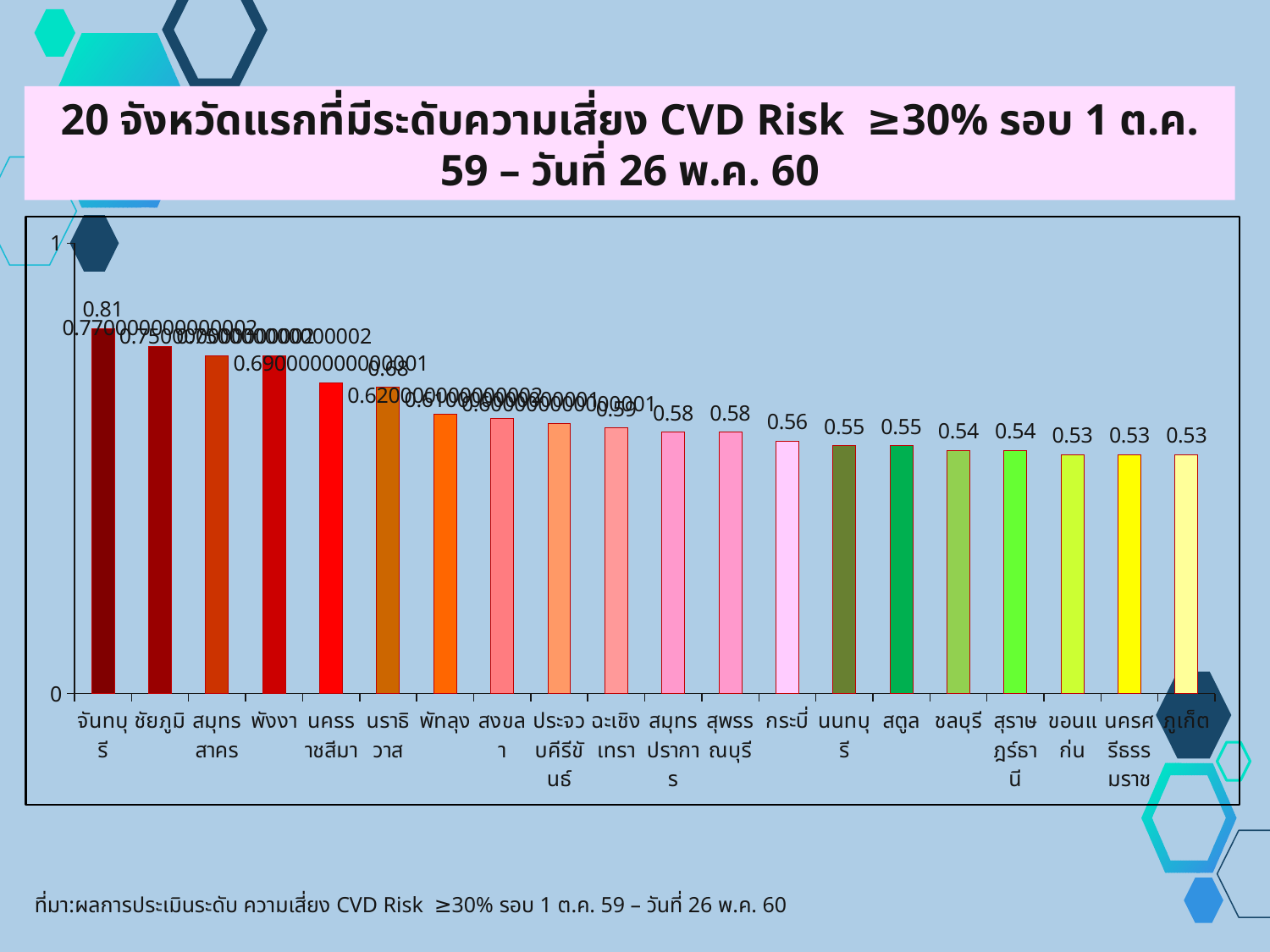
What is the value shown for ชลบุรี? 0.54 Do the values rise or fall moving from left to right along the x axis? fall What is the value shown for ภูเก็ต? 0.53 What is the title of the chart on the slide? 20 จังหวัดแรกที่มีระดับความเสี่ยง CVD Risk ≥30% รอบ 1 ต.ค. 59 – วันที่ 26 พ.ค. 60 What is the value shown for นนทบุรี? 0.55 What is the difference between the values for จันทบุรี and ภูเก็ต? 0.28 Which province has the highest value in the chart? จันทบุรี What kind of chart is shown on the slide? bar chart How many provinces are plotted in the chart? 20 What is the value shown for จันทบุรี? 0.81 Which has a larger value, กระบี่ or สตูล? กระบี่ What is the value shown for กระบี่? 0.56